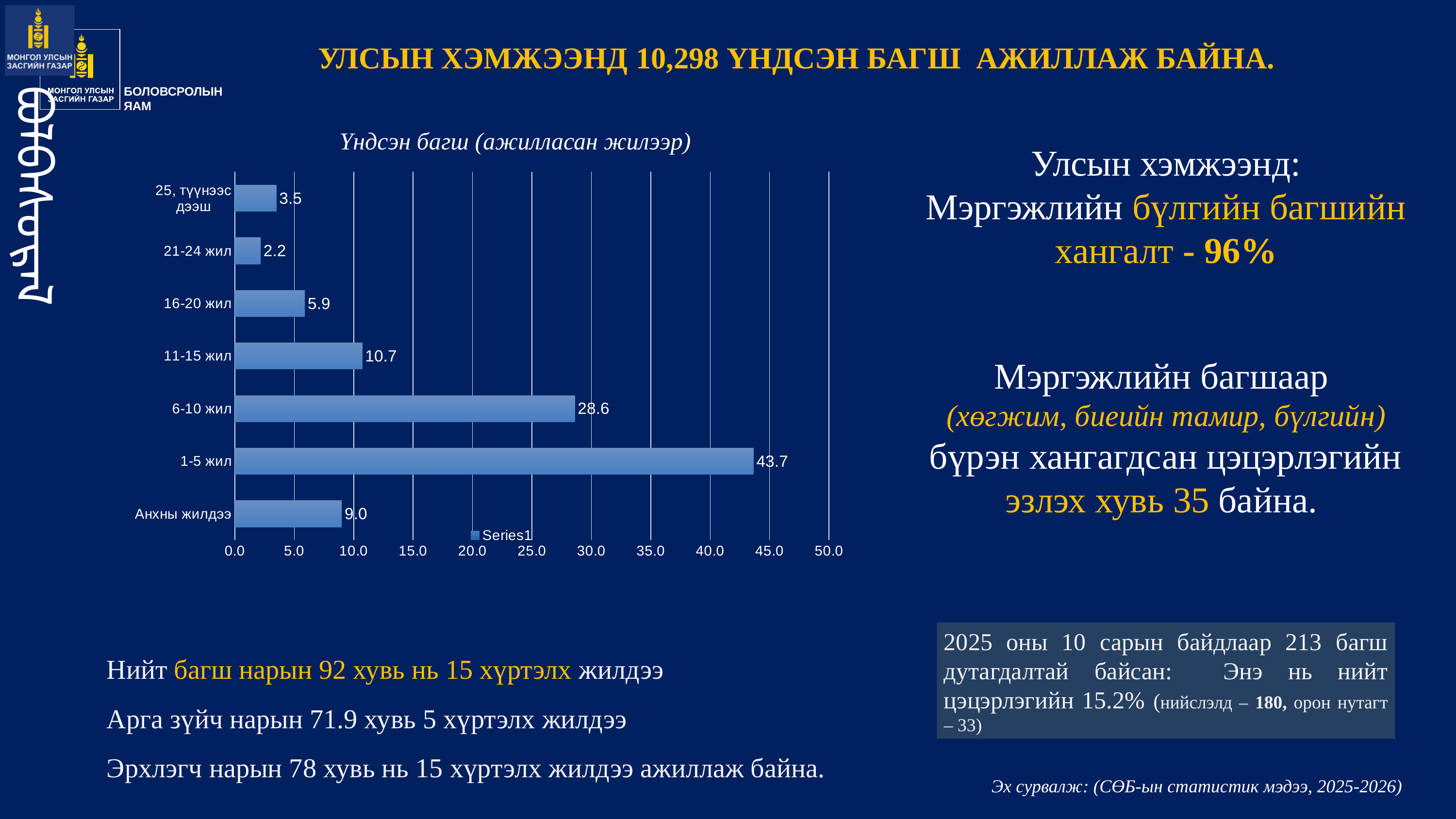
What kind of chart is shown on the slide? bar chart How many categories are shown on the chart? 7 How many series does the legend list? 1 Which category has the lowest value? 21-24 жил What is the difference between the values for "1-5 жил" and "6-10 жил"? 15.1 Which category has the highest value? 1-5 жил Which is larger, the value for "11-15 жил" or the value for "Анхны жилдээ"? 11-15 жил What is the value for the "Анхны жилдээ" category? 9.0 Is the value for "6-10 жил" greater or less than 25.0? greater What is the value for the "21-24 жил" category? 2.2 What is the value for the "1-5 жил" category? 43.7 What is the title of the chart? Үндсэн багш (ажилласан жилээр)